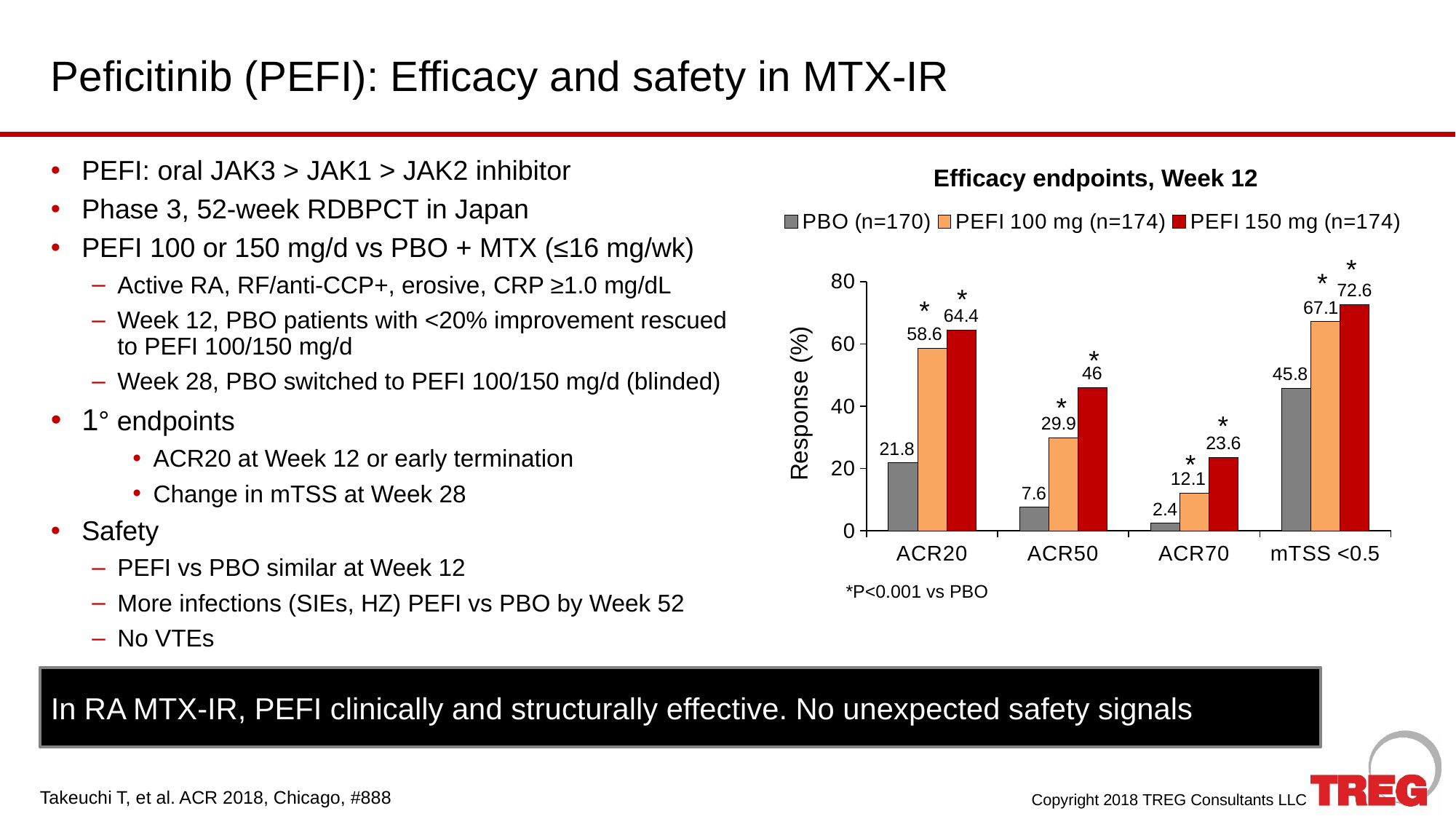
How many series does the legend list? 3 Which is larger for ACR70: PEFI 100 mg or PEFI 150 mg? PEFI 150 mg What is the ACR20 response for PEFI 150 mg (n=174)? 64.4 Which endpoint has the lowest value for PBO (n=170)? ACR70 Is the value for PBO at mTSS <0.5 greater or less than 40? greater What is the difference between PEFI 150 mg and PBO for ACR20? 42.6 What is the ACR50 response for PBO (n=170)? 7.6 How many endpoint categories are shown on the x axis? 4 Which endpoint has the highest value for PEFI 150 mg (n=174)? mTSS <0.5 What is the mTSS <0.5 value for PEFI 100 mg (n=174)? 67.1 What kind of chart is shown on the slide? Bar chart What is the title of the chart? Efficacy endpoints, Week 12